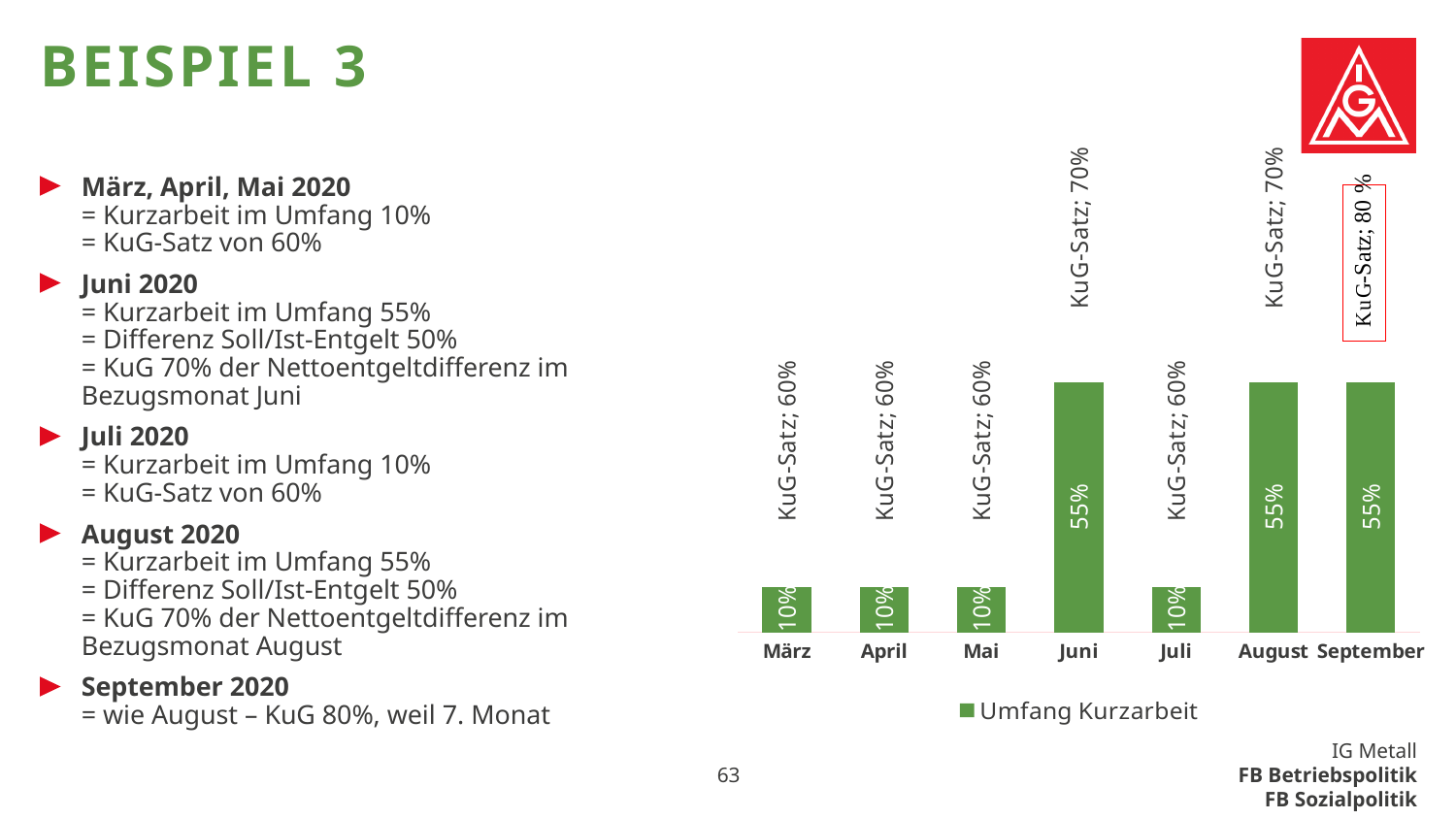
What KuG-Satz is labelled above the bar for September? KuG-Satz; 80 % How many categories are shown on the x axis of the chart? 7 What is the value for März in the chart? 10% What kind of chart is shown on the slide? bar chart What is the value for Juli in the chart? 10% What is the value for September in the chart? 55% Which is larger, the value for August or the value for Juli? August How many series does the chart legend list? 1 What KuG-Satz is labelled above the bar for Juni? KuG-Satz; 70% What is the value for Juni in the chart? 55% What is the name of the series in the chart legend? Umfang Kurzarbeit What is the difference between the values for Juni and Mai? 45%